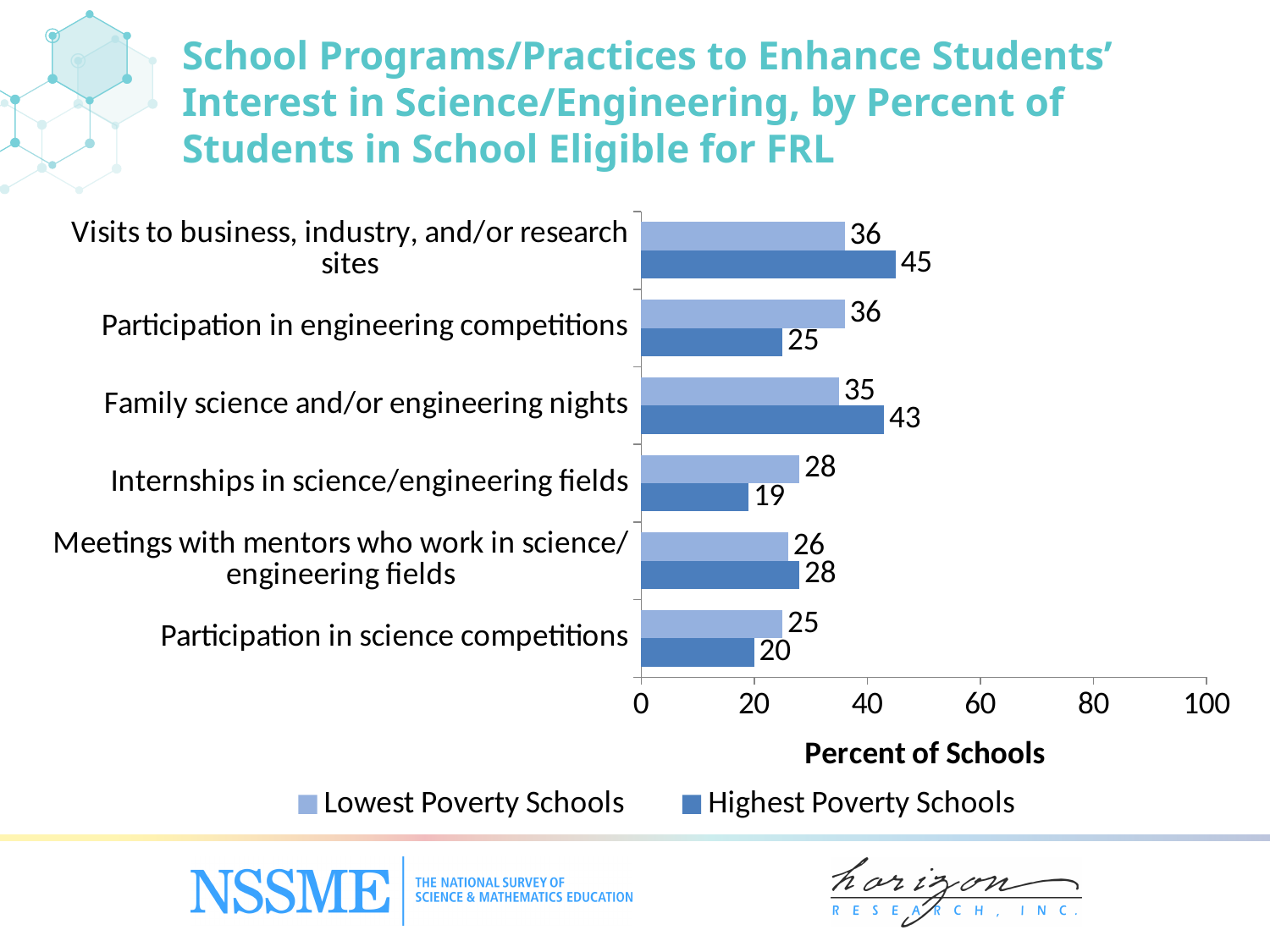
What is the difference between Highest Poverty Schools and Lowest Poverty Schools for Family science and/or engineering nights? 8 How many series does the legend list? 2 How many categories are shown on the chart? 6 Which category has the lowest value for Lowest Poverty Schools? Participation in science competitions What is the value for Lowest Poverty Schools for Internships in science/engineering fields? 28 What is the value for Highest Poverty Schools for Visits to business, industry, and/or research sites? 45 For Participation in engineering competitions, which is larger: Lowest Poverty Schools or Highest Poverty Schools? Lowest Poverty Schools Which category has the highest value for Highest Poverty Schools? Visits to business, industry, and/or research sites Is the value for Highest Poverty Schools for Visits to business, industry, and/or research sites greater or less than 40? greater What is the value for Highest Poverty Schools for Participation in science competitions? 20 What kind of chart is shown on the slide? bar chart Which category has the lowest value for Highest Poverty Schools? Internships in science/engineering fields